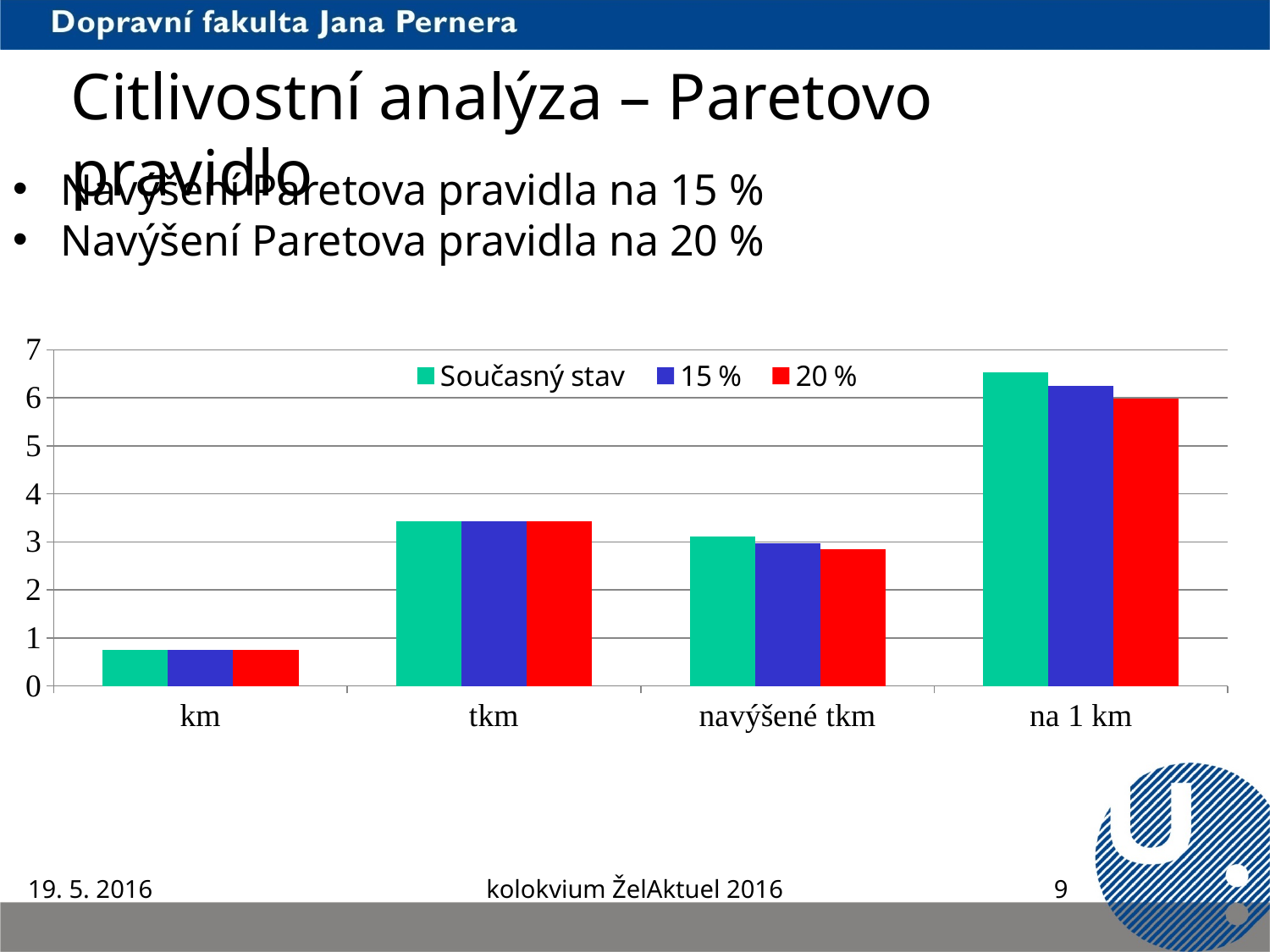
How many categories are shown on the x axis of the chart? 4 Which category has the highest bars in the chart? na 1 km What is the first series listed in the chart legend? Současný stav Is the value for 20 % in the tkm category greater or less than 3? greater What kind of chart is shown on the slide? bar chart Which category has the lowest bars in the chart? km Is the value for Současný stav in the na 1 km category greater or less than 6? greater Is the value for 20 % in the navýšené tkm category greater or less than 4? less In the na 1 km category, which is larger: the Současný stav bar or the 20 % bar? Současný stav How many series does the chart legend list? 3 Which series is shown in red in the chart legend? 20 %